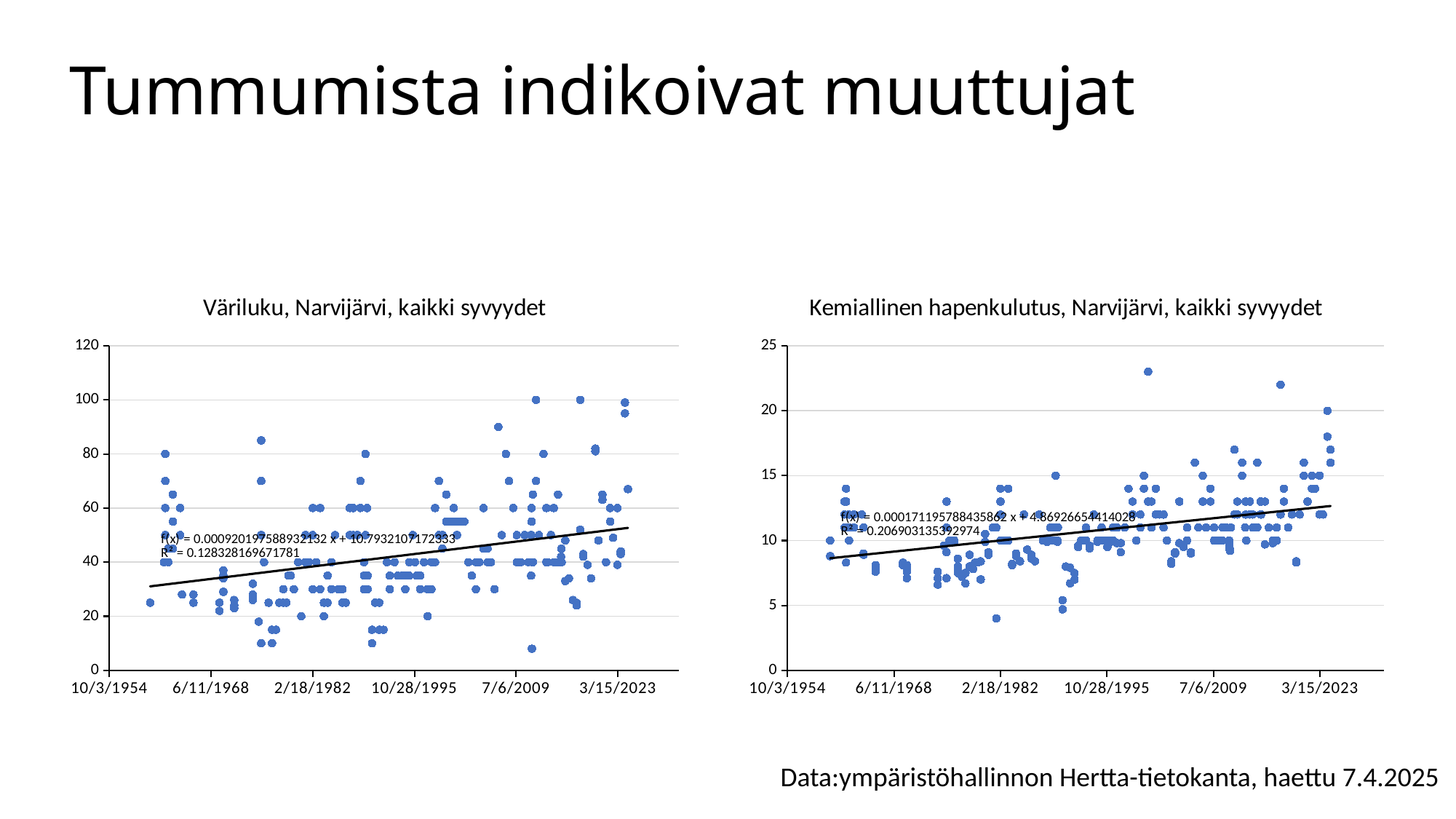
What is the R² value printed on the right chart (Kemiallinen hapenkulutus)? 0.206903135392974 What is the maximum value shown on the y axis of the right chart (Kemiallinen hapenkulutus)? 25 In the right chart (Kemiallinen hapenkulutus), is the highest plotted point greater or less than 20? greater Which chart shows the higher R² value, the left (Väriluku) or the right (Kemiallinen hapenkulutus)? the right (Kemiallinen hapenkulutus) In the right chart (Kemiallinen hapenkulutus), does the fitted trend line rise or fall along the x axis? rise In the left chart (Väriluku), is the highest plotted point greater or less than 80? greater What is the R² value printed on the left chart (Väriluku)? 0.128328169671781 What is the trend line equation printed on the left chart (Väriluku)? f(x) = 0.000920197588932132 x + 10.7932107172333 What kind of chart is the right chart titled "Kemiallinen hapenkulutus, Narvijärvi, kaikki syvyydet"? scatter chart What is the trend line equation printed on the right chart (Kemiallinen hapenkulutus)? f(x) = 0.000171195788435862 x + 4.86926654414028 In the left chart (Väriluku), does the fitted trend line rise or fall along the x axis? rise What kind of chart is the left chart titled "Väriluku, Narvijärvi, kaikki syvyydet"? scatter chart